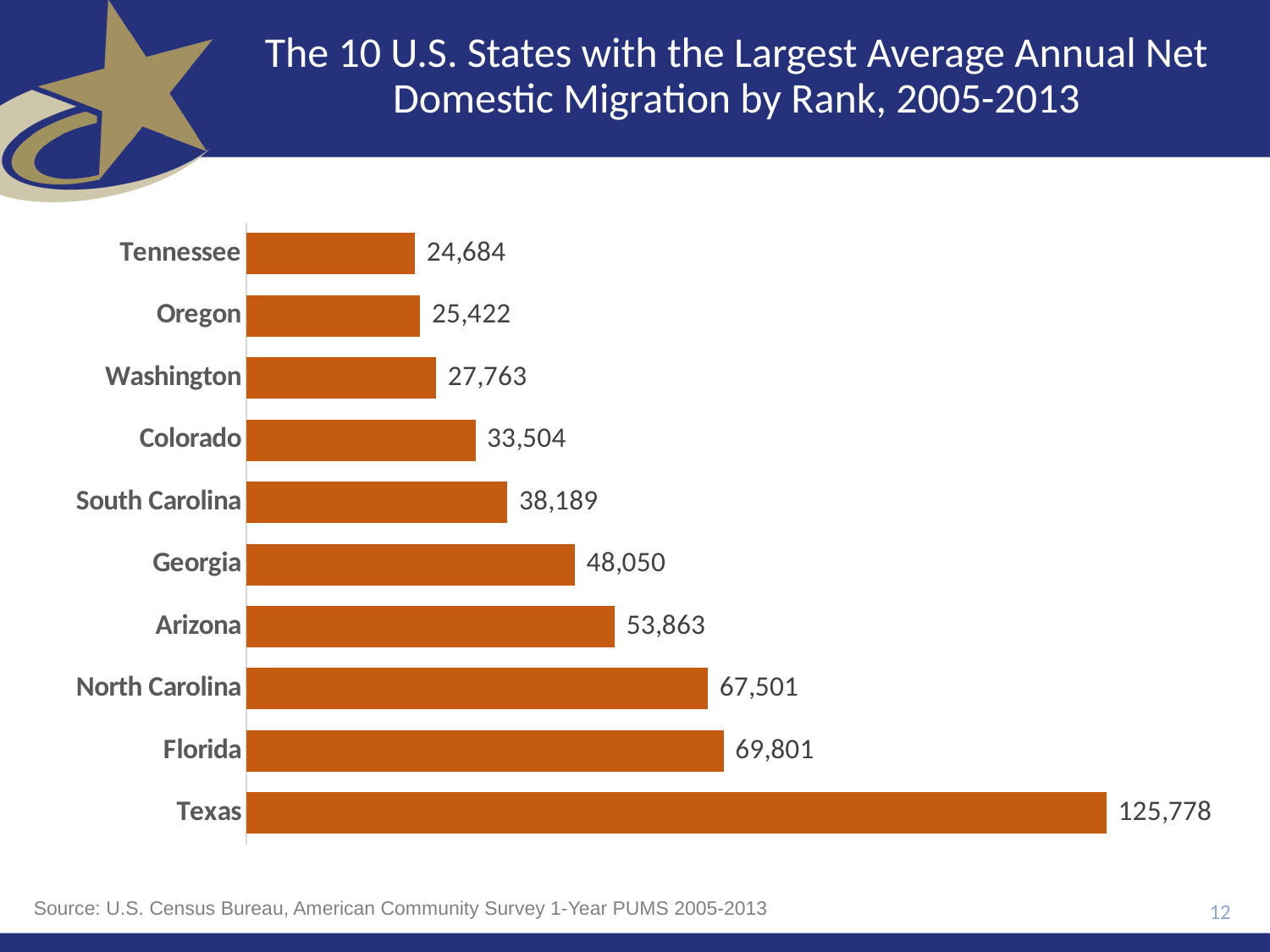
What is the average annual net domestic migration for Texas? 125,778 Which has a larger value, Arizona or South Carolina? Arizona What is the value shown for Georgia? 48,050 What is the value shown for Washington? 27,763 Which state has the smallest value on the chart? Tennessee Which has a larger value, Colorado or Oregon? Colorado What is the title of the chart? The 10 U.S. States with the Largest Average Annual Net Domestic Migration by Rank, 2005-2013 What is the difference between the values for Texas and Florida? 55,977 What is the difference between the values for Florida and North Carolina? 2,300 What type of chart is shown on the slide? Bar chart How many states are shown on the chart? 10 Which state has the largest average annual net domestic migration? Texas